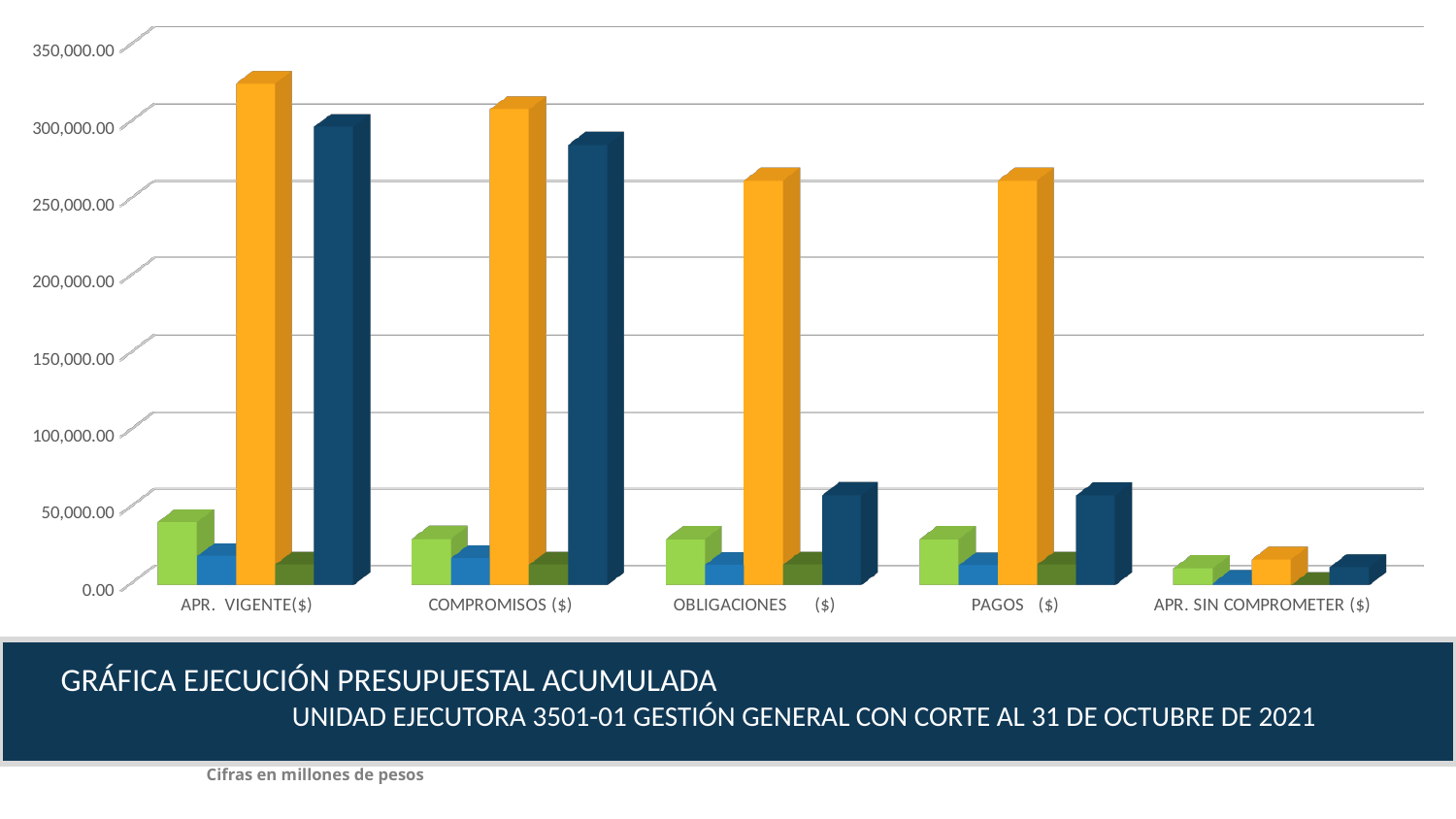
What is the highest value shown on the vertical axis of the chart? 350,000.00 What kind of chart is shown on the slide? bar chart Do the orange bars rise or fall from left to right across the categories? fall How many categories are shown on the x axis of the chart? 5 Is the orange bar for APR. VIGENTE($) greater or less than 300,000.00? greater Is the orange bar for APR. SIN COMPROMETER ($) greater or less than 50,000.00? less Which has the taller orange bar, APR. VIGENTE($) or COMPROMISOS ($)? APR. VIGENTE($) Is the orange bar for OBLIGACIONES ($) greater or less than 200,000.00? greater Which category has the shortest orange bar? APR. SIN COMPROMETER ($) According to the note below the chart, in what units are the figures expressed? millones de pesos Which category has the tallest orange bar? APR. VIGENTE($)